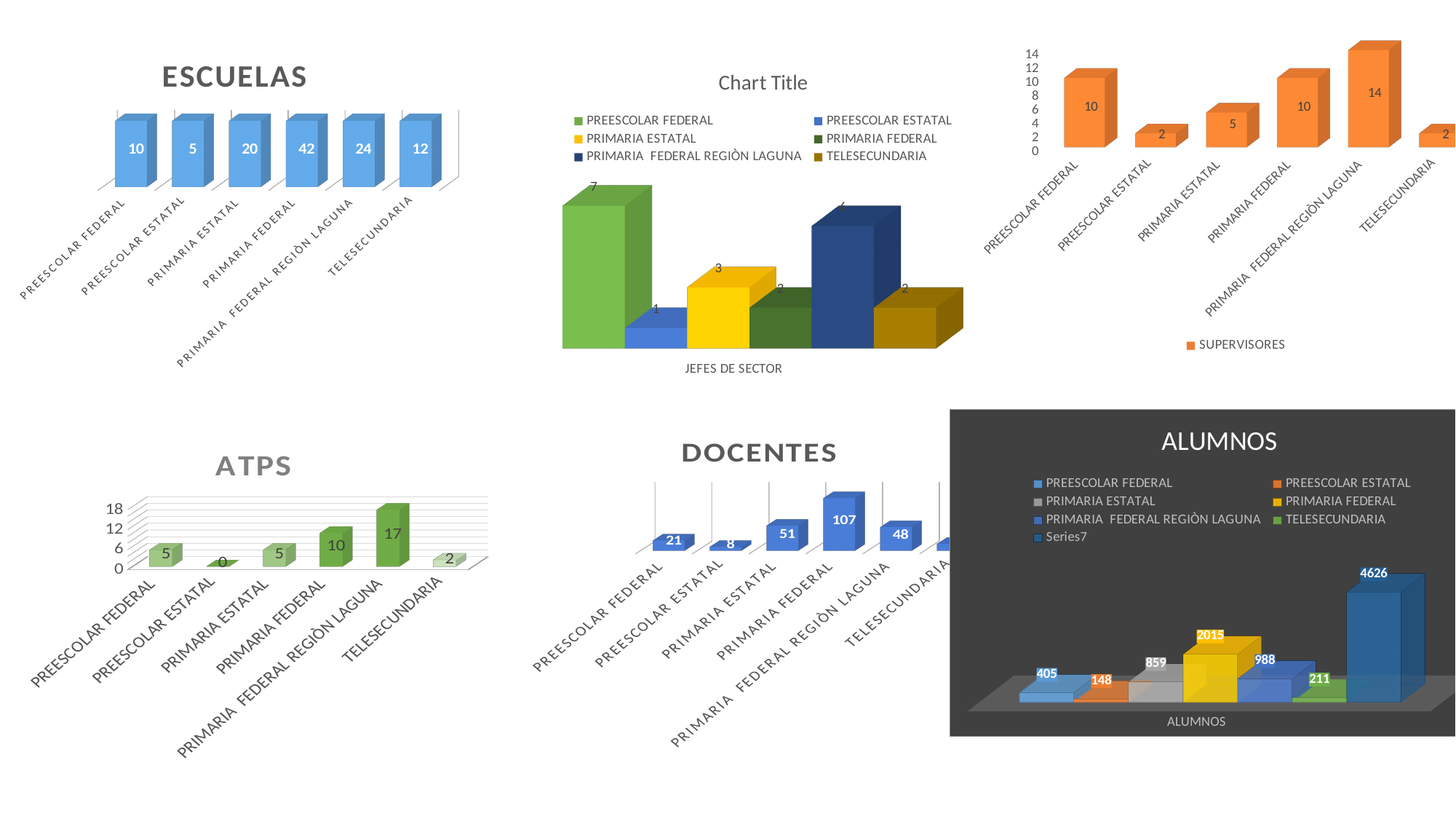
In the ALUMNOS chart, what is the value for PRIMARIA FEDERAL? 2015 In the ESCUELAS chart, what is the value for PRIMARIA FEDERAL? 42 How many series does the legend of the ALUMNOS chart list? 7 In the ESCUELAS chart, what is the difference between PRIMARIA FEDERAL REGIÓN LAGUNA and TELESECUNDARIA? 12 In the DOCENTES chart, which is larger, PRIMARIA ESTATAL or PRIMARIA FEDERAL REGIÓN LAGUNA? PRIMARIA ESTATAL In the chart titled "Chart Title" (JEFES DE SECTOR), what is the value for PREESCOLAR FEDERAL? 7 In the SUPERVISORES chart (top right), what is the value for PRIMARIA ESTATAL? 5 In the ESCUELAS chart, which category has the lowest value? PREESCOLAR ESTATAL In the SUPERVISORES chart (top right), which category has the highest value? PRIMARIA FEDERAL REGIÓN LAGUNA In the DOCENTES chart, what is the value for PRIMARIA FEDERAL? 107 In the ATPS chart, what is the value for PRIMARIA FEDERAL REGIÓN LAGUNA? 17 In the ATPS chart, what is the value for PREESCOLAR ESTATAL? 0